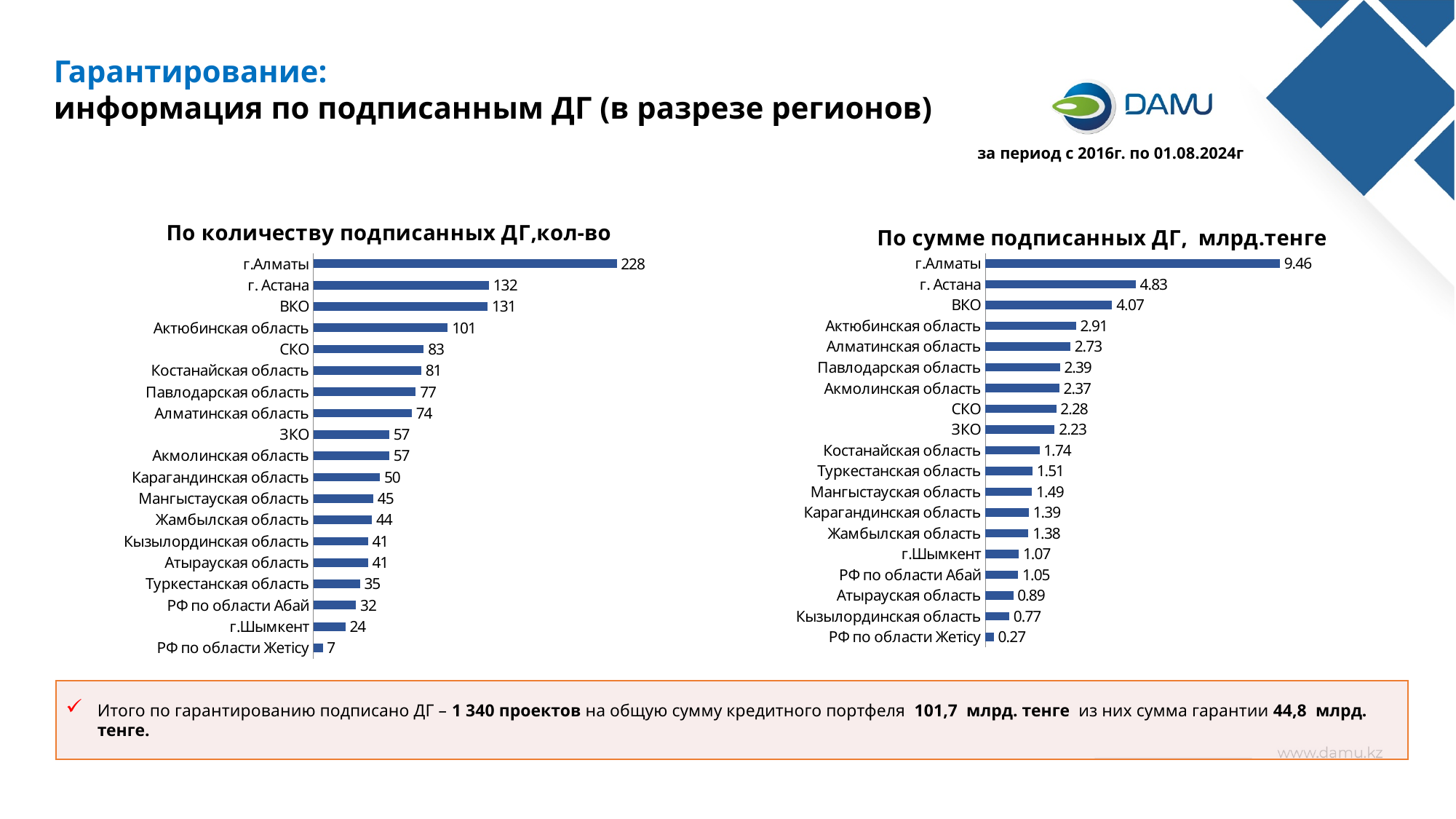
In the chart 'По сумме подписанных ДГ, млрд.тенге', what is the difference between г.Алматы and г. Астана? 4.63 In the chart 'По сумме подписанных ДГ, млрд.тенге', what is the value for Павлодарская область? 2.39 In the chart 'По количеству подписанных ДГ,кол-во', which region has the highest value? г.Алматы In the chart 'По количеству подписанных ДГ,кол-во', what is the value for г.Шымкент? 24 In the chart 'По количеству подписанных ДГ,кол-во', what is the value for г. Астана? 132 In the chart 'По количеству подписанных ДГ,кол-во', which region has the lowest value? РФ по области Жетісу In the chart 'По сумме подписанных ДГ, млрд.тенге', which region has the highest value? г.Алматы In the chart 'По количеству подписанных ДГ,кол-во', what is the difference between г.Алматы and ВКО? 97 In the chart 'По сумме подписанных ДГ, млрд.тенге', which region has the lowest value? РФ по области Жетісу In the chart 'По сумме подписанных ДГ, млрд.тенге', which is larger: the value for Костанайская область or Туркестанская область? Костанайская область In the chart 'По количеству подписанных ДГ,кол-во', how many regions are shown? 19 What type of chart is 'По сумме подписанных ДГ, млрд.тенге'? Bar chart